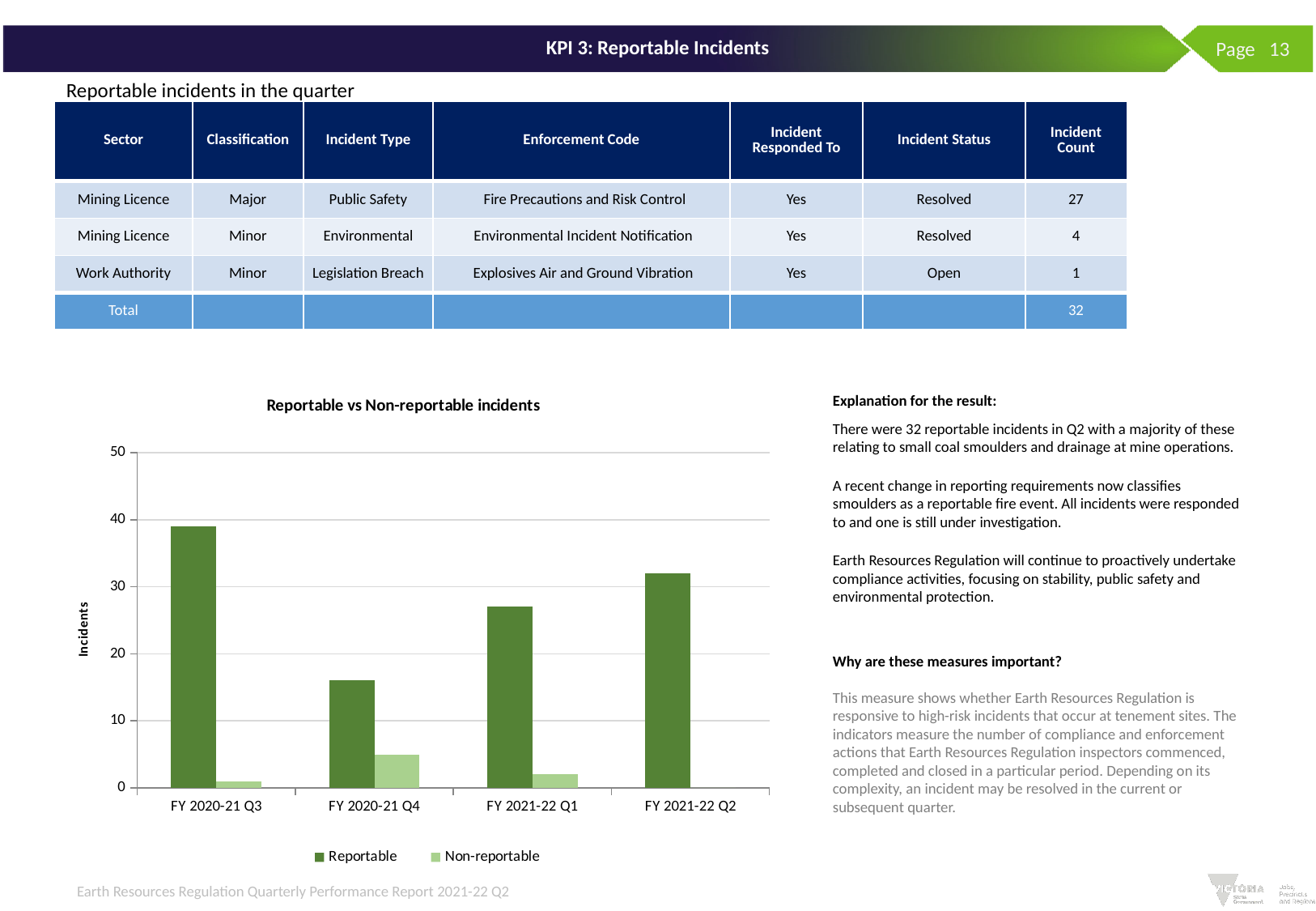
In the 'Reportable vs Non-reportable incidents' chart, is the Reportable value for FY 2020-21 Q3 greater or less than 30? greater What kind of chart is the 'Reportable vs Non-reportable incidents' chart? Bar chart How many series does the legend of the 'Reportable vs Non-reportable incidents' chart list? 2 In the 'Reportable vs Non-reportable incidents' chart, which quarter has the lowest number of Reportable incidents? FY 2020-21 Q4 In the 'Reportable vs Non-reportable incidents' chart, which quarter has the highest number of Reportable incidents? FY 2020-21 Q3 What is the label on the vertical axis of the 'Reportable vs Non-reportable incidents' chart? Incidents In the 'Reportable vs Non-reportable incidents' chart, which quarter has the highest number of Non-reportable incidents? FY 2020-21 Q4 In the 'Reportable vs Non-reportable incidents' chart, is the Reportable value for FY 2020-21 Q4 greater or less than 20? less In the 'Reportable vs Non-reportable incidents' chart, which is larger: the Reportable value for FY 2021-22 Q1 or for FY 2021-22 Q2? FY 2021-22 Q2 How many quarters are shown on the x axis of the 'Reportable vs Non-reportable incidents' chart? 4 In the 'Reportable vs Non-reportable incidents' chart, is the Non-reportable value for FY 2020-21 Q4 greater or less than 10? less